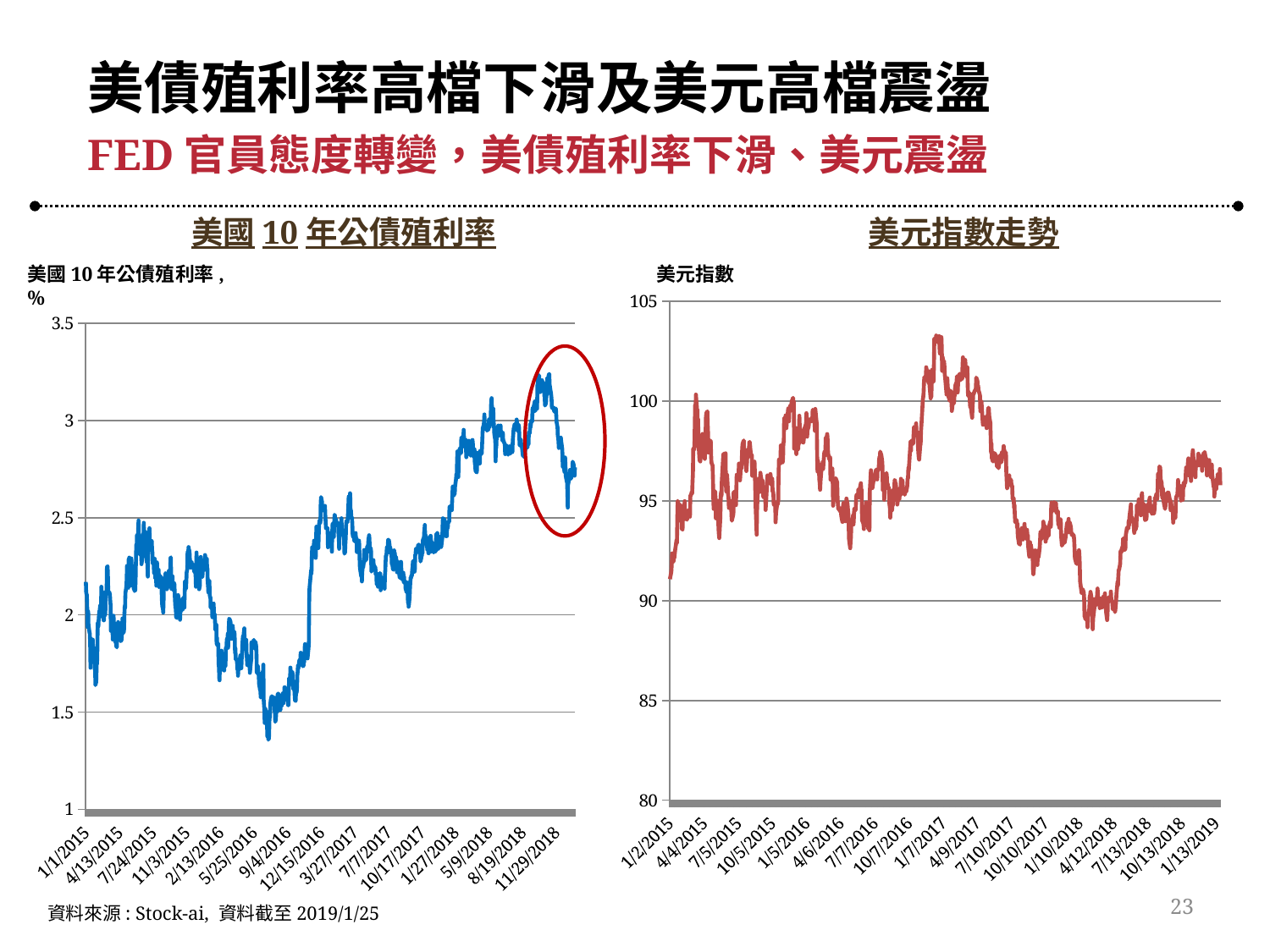
What kind of chart is the 美國 10 年公債殖利率 chart on the left? line chart In the 美國 10 年公債殖利率 chart, is the value at the right end of the line (early 2019) greater or less than 2.5? greater What colour is the line in the 美國 10 年公債殖利率 chart? blue In the 美元指數走勢 chart, is the peak value of the line (early 2017) greater or less than 100? greater In the 美元指數走勢 chart, does the line rise or fall between 1/7/2017 and 1/10/2018? fall In the 美元指數走勢 chart, is the value at the start of the line (1/2/2015) greater or less than 95? less How many data series are plotted in the 美元指數走勢 chart? 1 In the 美國 10 年公債殖利率 chart, does the line rise or fall between 11/29/2018 and the end of the series? fall What kind of chart is the 美元指數走勢 chart on the right? line chart